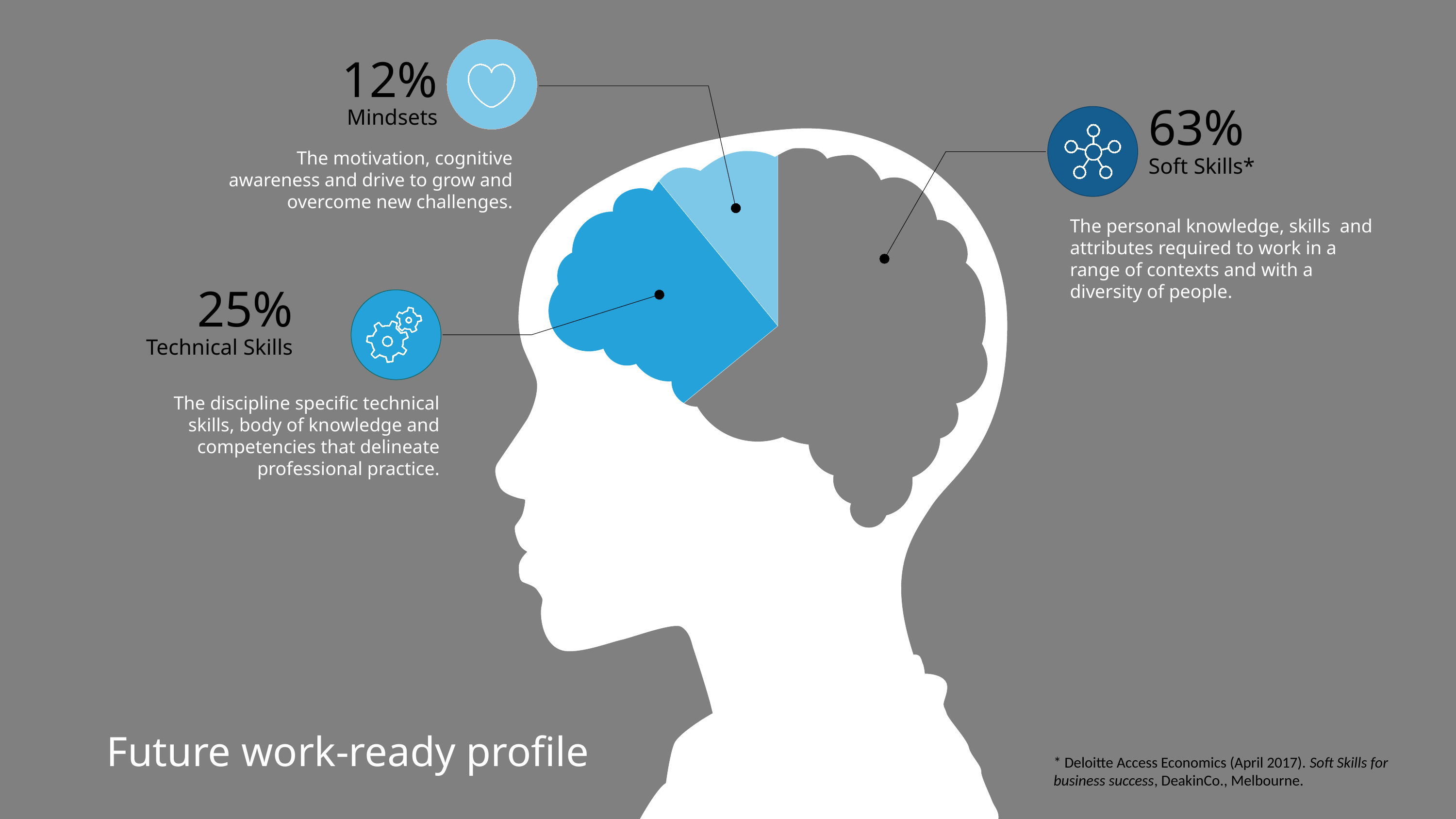
Which category has the smallest share of the brain diagram? Mindsets Which category has the largest share of the brain diagram? Soft Skills How many categories are shown in the brain diagram? 3 What percentage is shown for Soft Skills? 63% What is the total of the three percentages shown? 100% What is the difference in percentage points between Technical Skills and Mindsets? 13 Which icon is shown in the circle next to Mindsets? A heart What is the title of the slide? Future work-ready profile Which is larger, the share for Technical Skills or the share for Mindsets? Technical Skills What percentage is shown for Mindsets? 12% What is the difference in percentage points between Soft Skills and Technical Skills? 38 What percentage is shown for Technical Skills? 25%